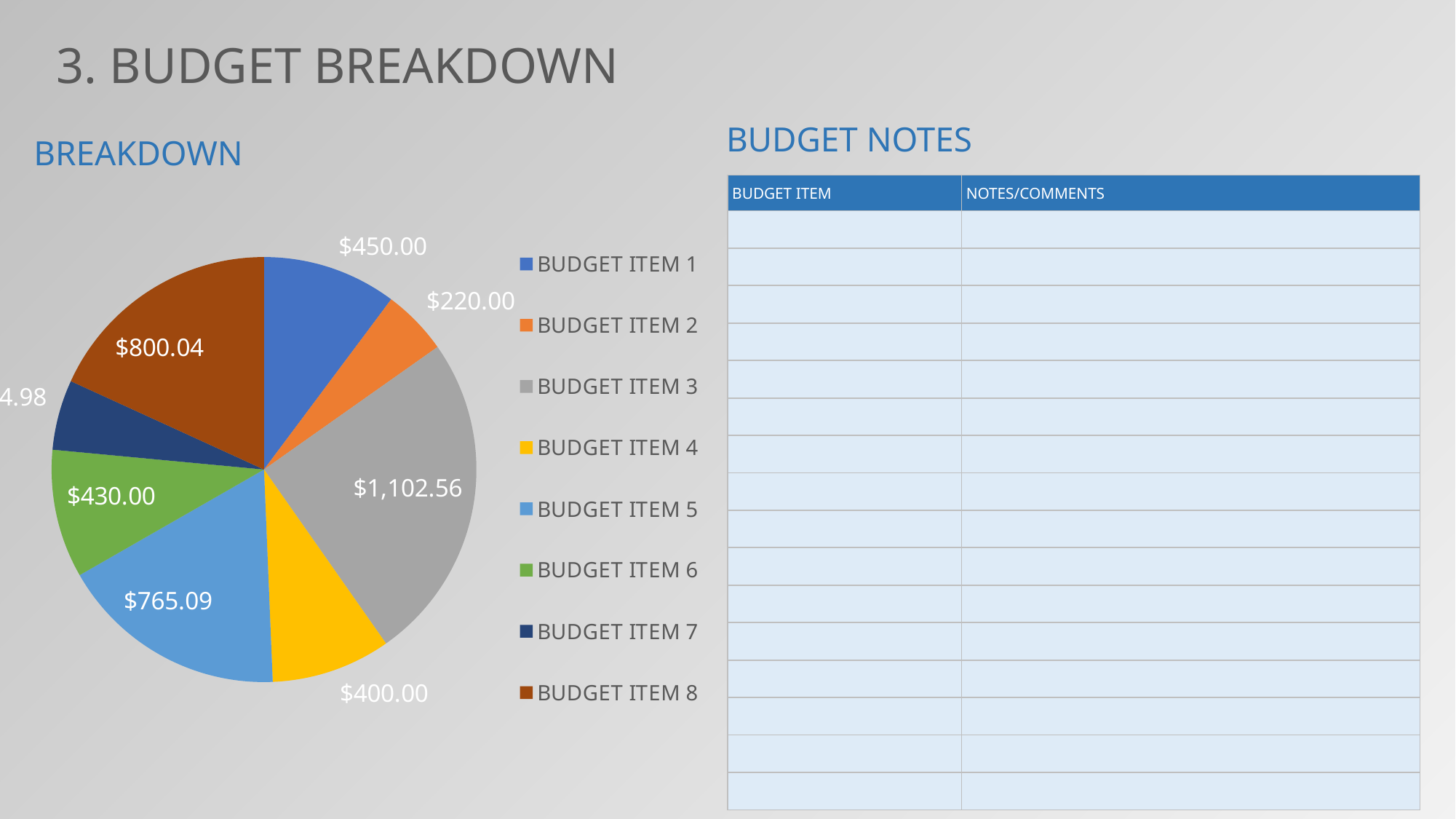
What is the value shown for BUDGET ITEM 2 in the pie chart? $220.00 What colour is the slice for BUDGET ITEM 4 in the pie chart? yellow What kind of chart is shown under the heading BREAKDOWN? pie chart What is the value shown for BUDGET ITEM 3 in the pie chart? $1,102.56 What is the difference between the values for BUDGET ITEM 8 and BUDGET ITEM 5? $34.95 Which budget item has the largest slice in the pie chart? BUDGET ITEM 3 What is the value shown for BUDGET ITEM 5 in the pie chart? $765.09 What is the difference between the values for BUDGET ITEM 3 and BUDGET ITEM 1? $652.56 Which is larger, the value for BUDGET ITEM 6 or BUDGET ITEM 4? BUDGET ITEM 6 How many budget items does the legend of the pie chart list? 8 What is the value shown for BUDGET ITEM 8 in the pie chart? $800.04 What is the value shown for BUDGET ITEM 1 in the pie chart? $450.00